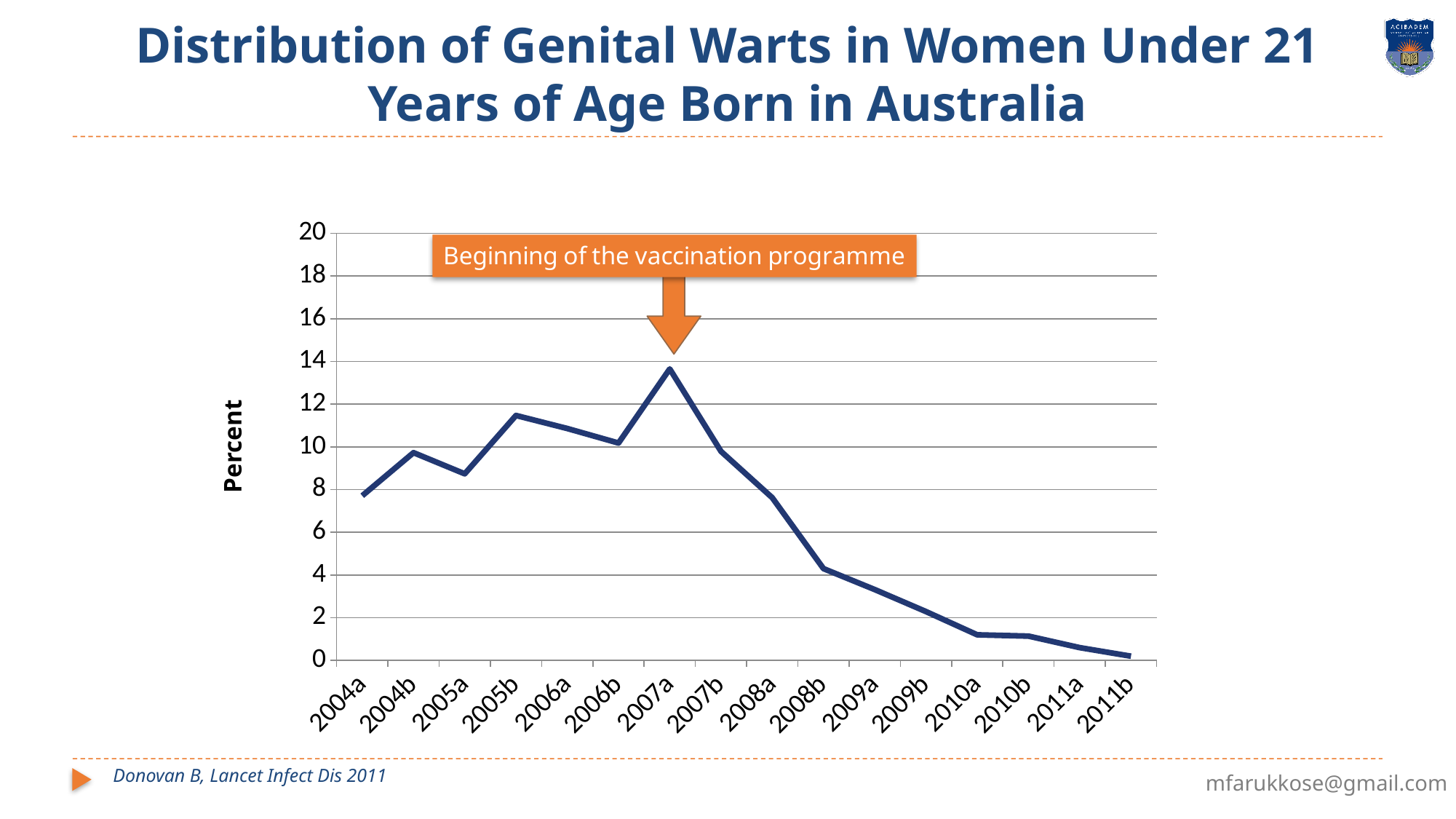
Is the value for 2008b greater or less than 6? less Which time point has the lowest value? 2011b Is the value for 2010a greater or less than 2? less What kind of chart is shown on the slide? line chart Is the value for 2007a greater or less than 12? greater Do the values rise or fall from 2007a to 2011b? fall Which time point has the highest value? 2007a Which is larger, the value for 2007a or the value for 2008a? 2007a How many time points are plotted along the x axis? 16 Which is larger, the value for 2005b or the value for 2006b? 2005b What is the label on the y axis? Percent